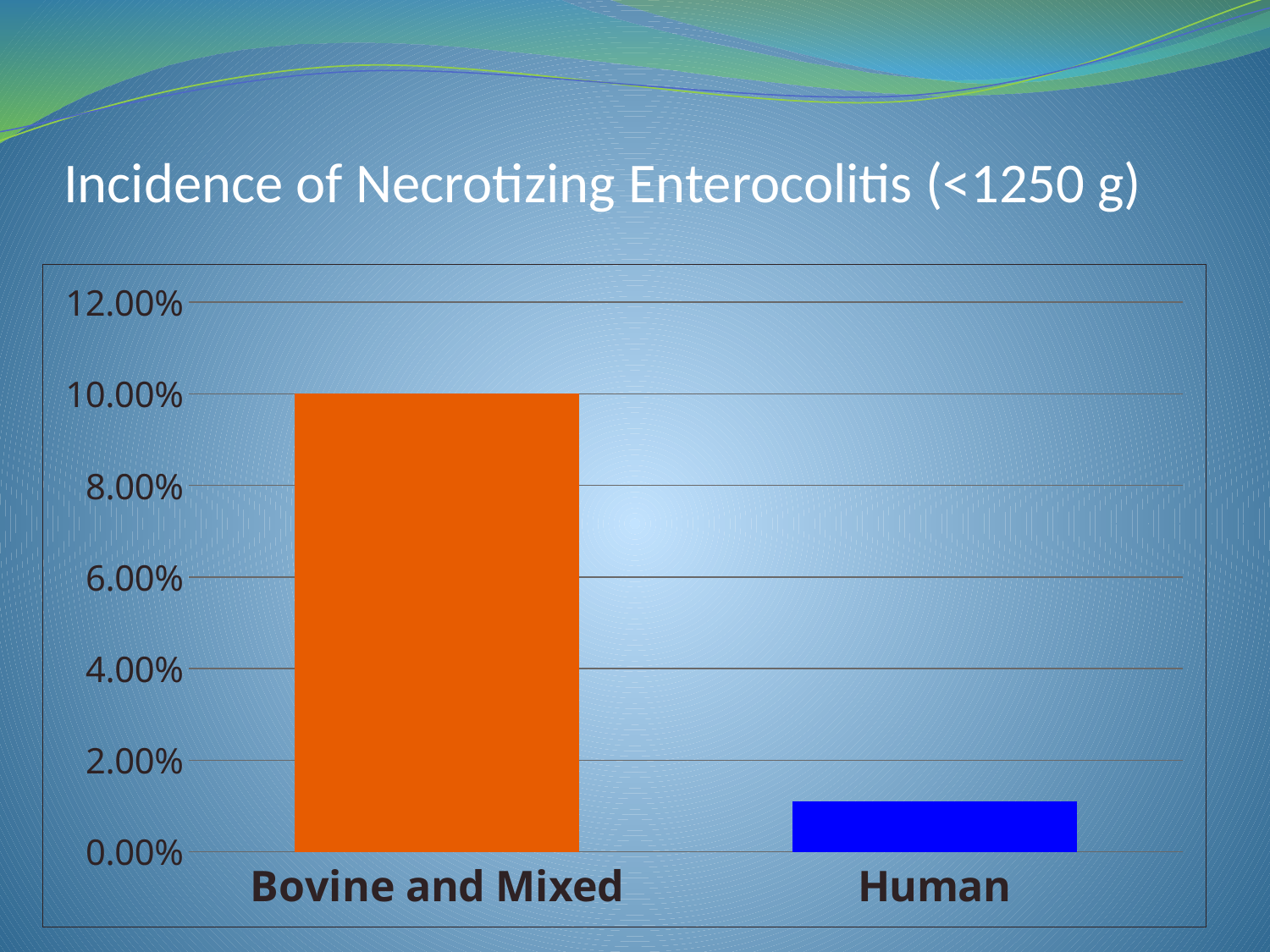
What colour is the bar for Human? blue What kind of chart is shown on the slide? bar chart Which is larger, the value for Bovine and Mixed or the value for Human? Bovine and Mixed Is the value for Human greater or less than 4.00%? less How many categories are plotted in the chart? 2 Which category has the lowest incidence of necrotizing enterocolitis? Human Is the value for Bovine and Mixed greater or less than 8.00%? greater Is the value for Human greater or less than 2.00%? less What is the title of the chart? Incidence of Necrotizing Enterocolitis (<1250 g) Which category has the highest incidence of necrotizing enterocolitis? Bovine and Mixed Do the values rise or fall from left to right across the categories? fall What is the incidence value for Bovine and Mixed? 10.00%